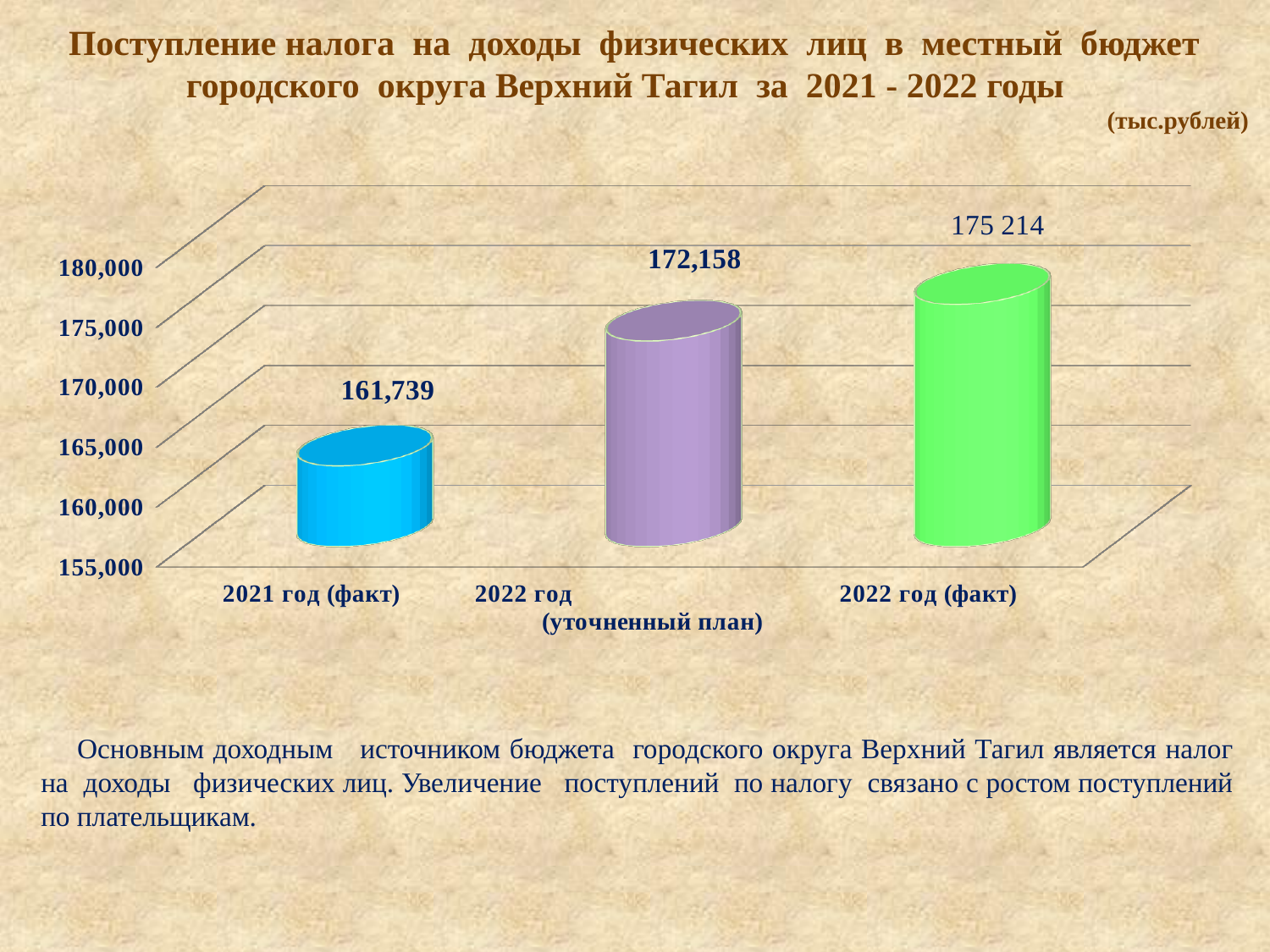
Is the value for 2021 год (факт) greater or less than 165,000? less Which is larger: the value for 2022 год (уточненный план) or the value for 2022 год (факт)? 2022 год (факт) What is the value for 2022 год (уточненный план)? 172,158 What is the value for 2022 год (факт)? 175 214 What is the value for 2021 год (факт)? 161,739 What kind of chart is shown on the slide? bar chart What is the difference between the values for 2022 год (факт) and 2021 год (факт)? 13,475 What is the difference between the values for 2022 год (уточненный план) and 2021 год (факт)? 10,419 Which category has the lowest value? 2021 год (факт) Do the values rise or fall from left to right along the x axis? rise Which category has the highest value? 2022 год (факт) How many categories are shown on the chart? 3